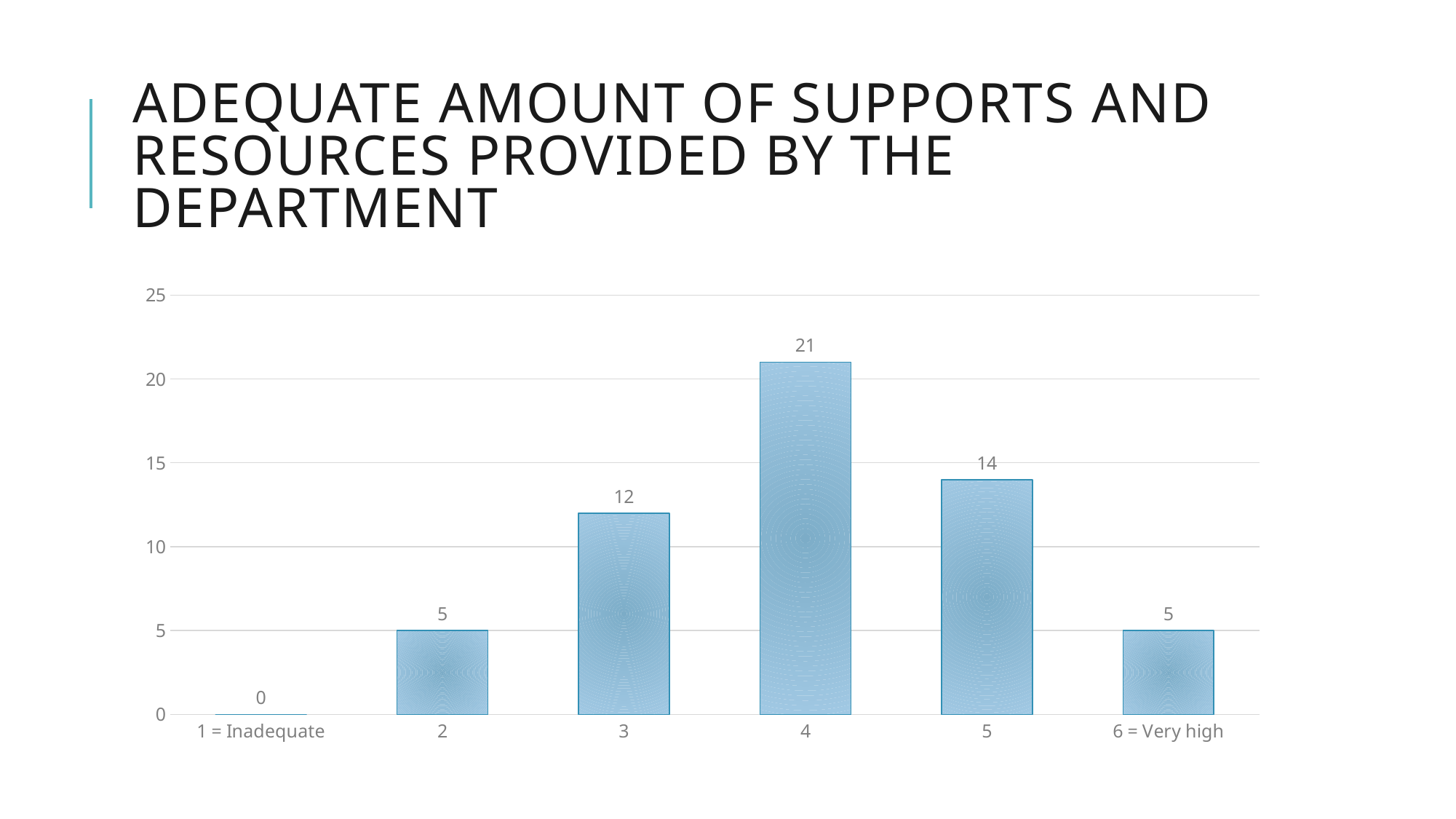
Which category has the highest value? 4 What kind of chart is shown on the slide? bar chart What is the title of the slide? Adequate amount of supports and resources provided by the department How many categories are shown on the x axis? 6 Which is larger, the value for category 3 or the value for category 5? category 5 What is the value for category 4? 21 What is the difference between the values for category 4 and category 5? 7 What is the value for the category '1 = Inadequate'? 0 What is the value for the category '6 = Very high'? 5 Which category has the lowest value? 1 = Inadequate Is the value for category 4 greater or less than 20? greater What is the value for category 3? 12